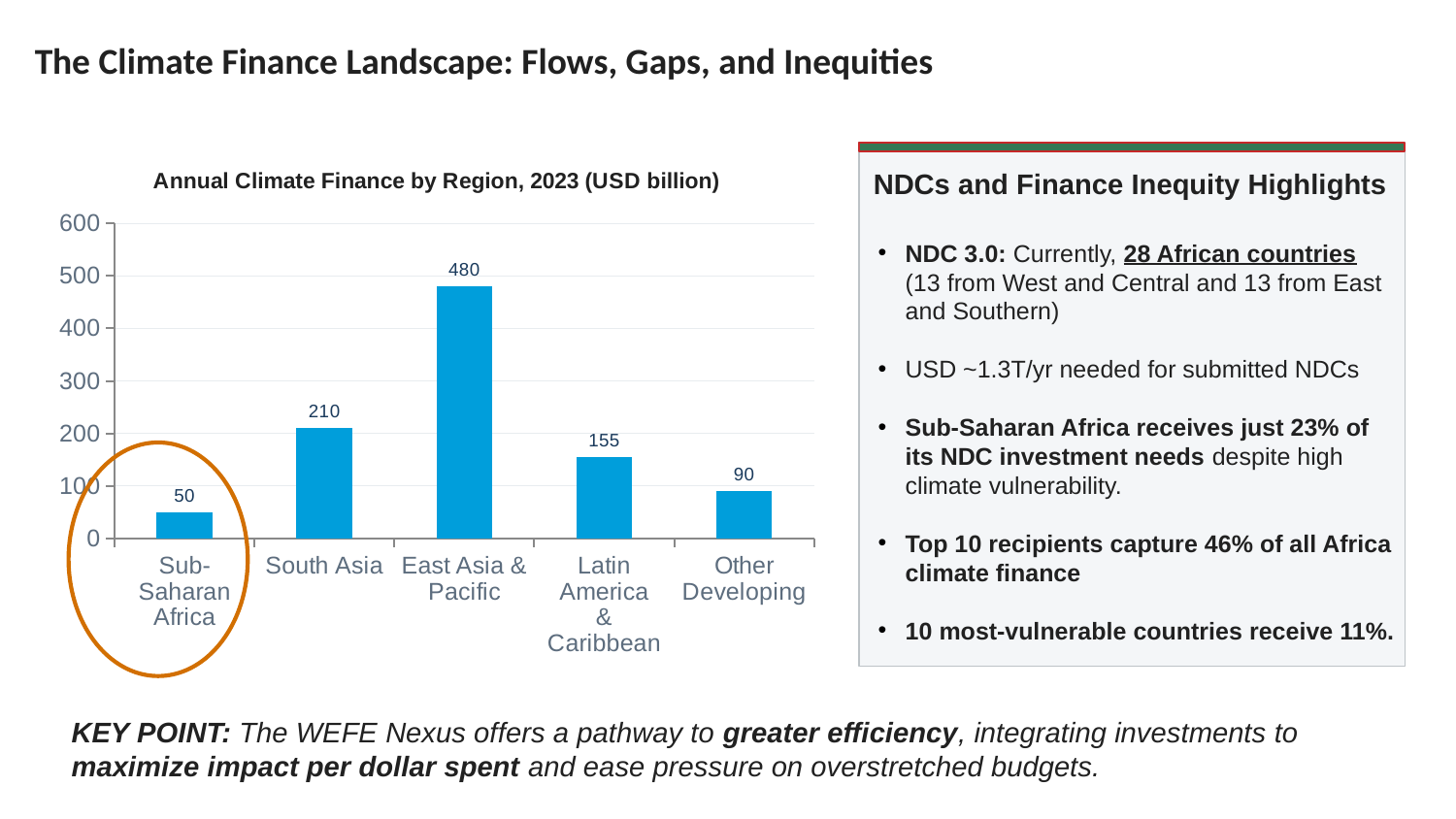
What is the title of the chart? Annual Climate Finance by Region, 2023 (USD billion) What is the difference between the values for East Asia & Pacific and South Asia? 270 Which is larger, the value for South Asia or the value for Latin America & Caribbean? South Asia How many regions are shown in the chart? 5 What is the difference between the values for Other Developing and Sub-Saharan Africa? 40 Which region has the highest annual climate finance? East Asia & Pacific What kind of chart is used to show annual climate finance by region? bar chart What is the annual climate finance value for Latin America & Caribbean? 155 Is the value for Other Developing greater or less than 100? less Which region has the lowest annual climate finance? Sub-Saharan Africa What is the annual climate finance value for Sub-Saharan Africa? 50 What is the annual climate finance value for East Asia & Pacific? 480